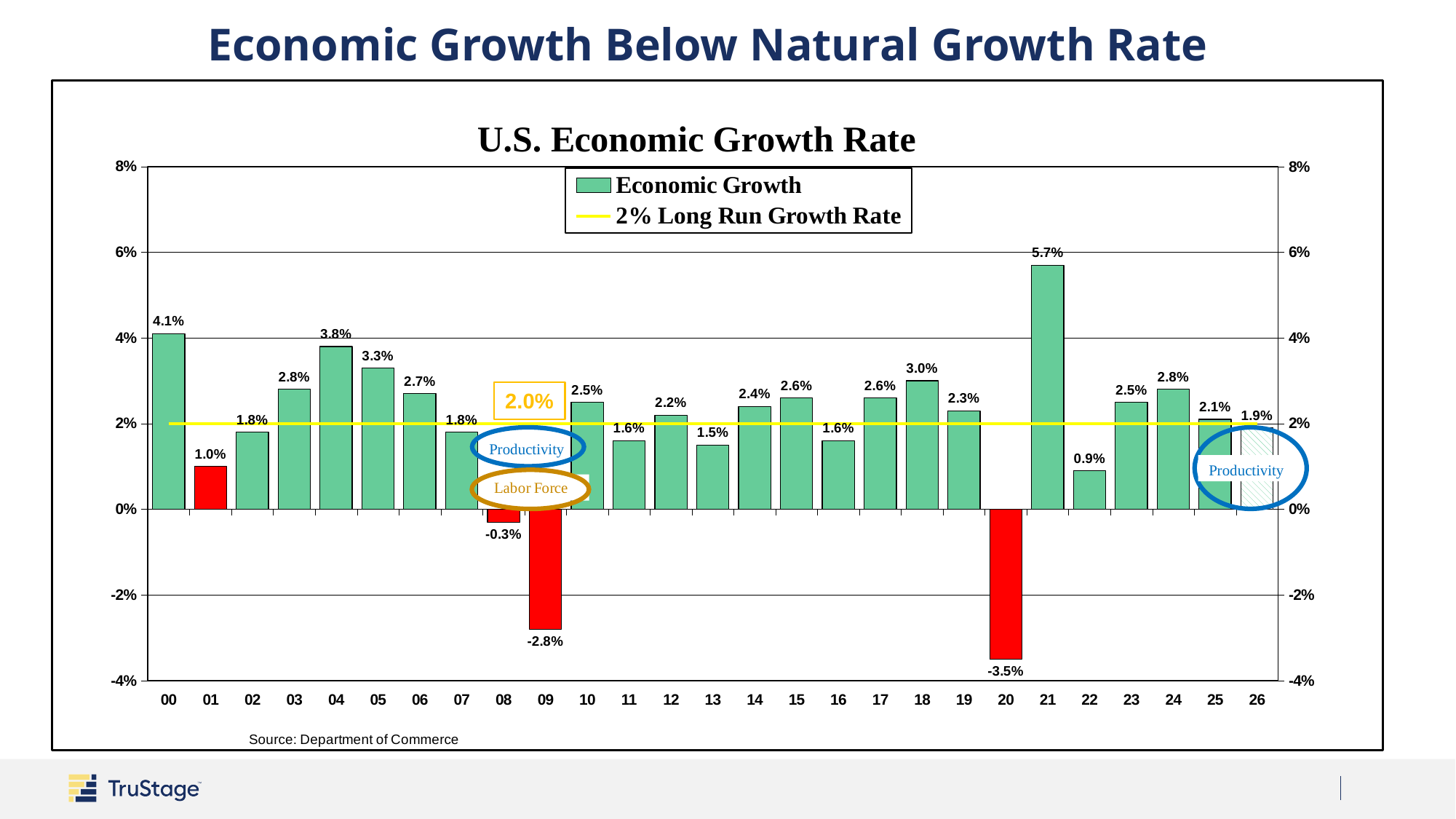
What kind of chart is used to show the economic growth rate? Bar chart How many series does the legend list? 2 What is the title of the chart? U.S. Economic Growth Rate Which year has the lowest economic growth rate? 20 What is the economic growth rate shown for 2026 (labelled 26)? 1.9% Is the growth rate for 2000 greater or less than 4%? greater What is the economic growth rate shown for 2021 (labelled 21)? 5.7% Which year has the highest economic growth rate? 21 How many years are shown on the x axis? 27 What is the difference between the growth rate in 2021 (5.7%) and in 2022 (0.9%)? 4.8 percentage points What is the economic growth rate shown for 2009 (labelled 09)? -2.8% Which year has a higher growth rate, 2004 or 2005? 04